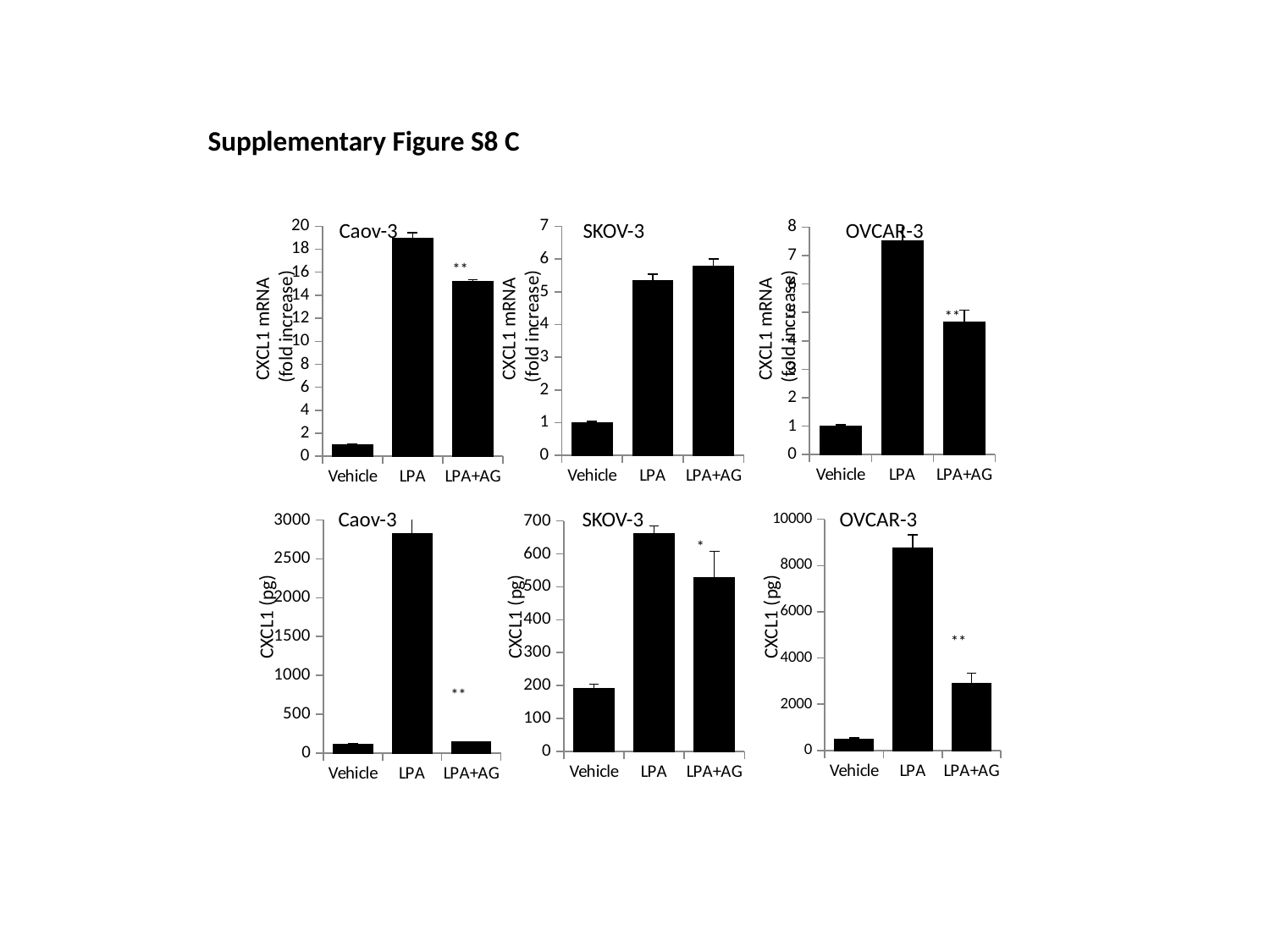
In the bottom-left chart (Caov-3, CXCL1 pg), is the value for LPA greater or less than 2500? greater In the bottom-right chart (OVCAR-3, CXCL1 pg), is the value for LPA+AG greater or less than 4000? less What is the y-axis label of the bottom-left chart (Caov-3)? CXCL1 (pg) How many categories are shown on the x axis of the bottom-right chart (OVCAR-3, CXCL1 pg)? 3 In the top-left chart (Caov-3, CXCL1 mRNA), which category has the highest value? LPA In the top-left chart (Caov-3, CXCL1 mRNA), is the value for LPA+AG greater or less than 14? greater What kind of chart is the top-left chart (Caov-3, CXCL1 mRNA)? bar chart In the top-right chart (OVCAR-3, CXCL1 mRNA), which is larger, LPA or LPA+AG? LPA In the bottom-middle chart (SKOV-3, CXCL1 pg), which category has the lowest value? Vehicle